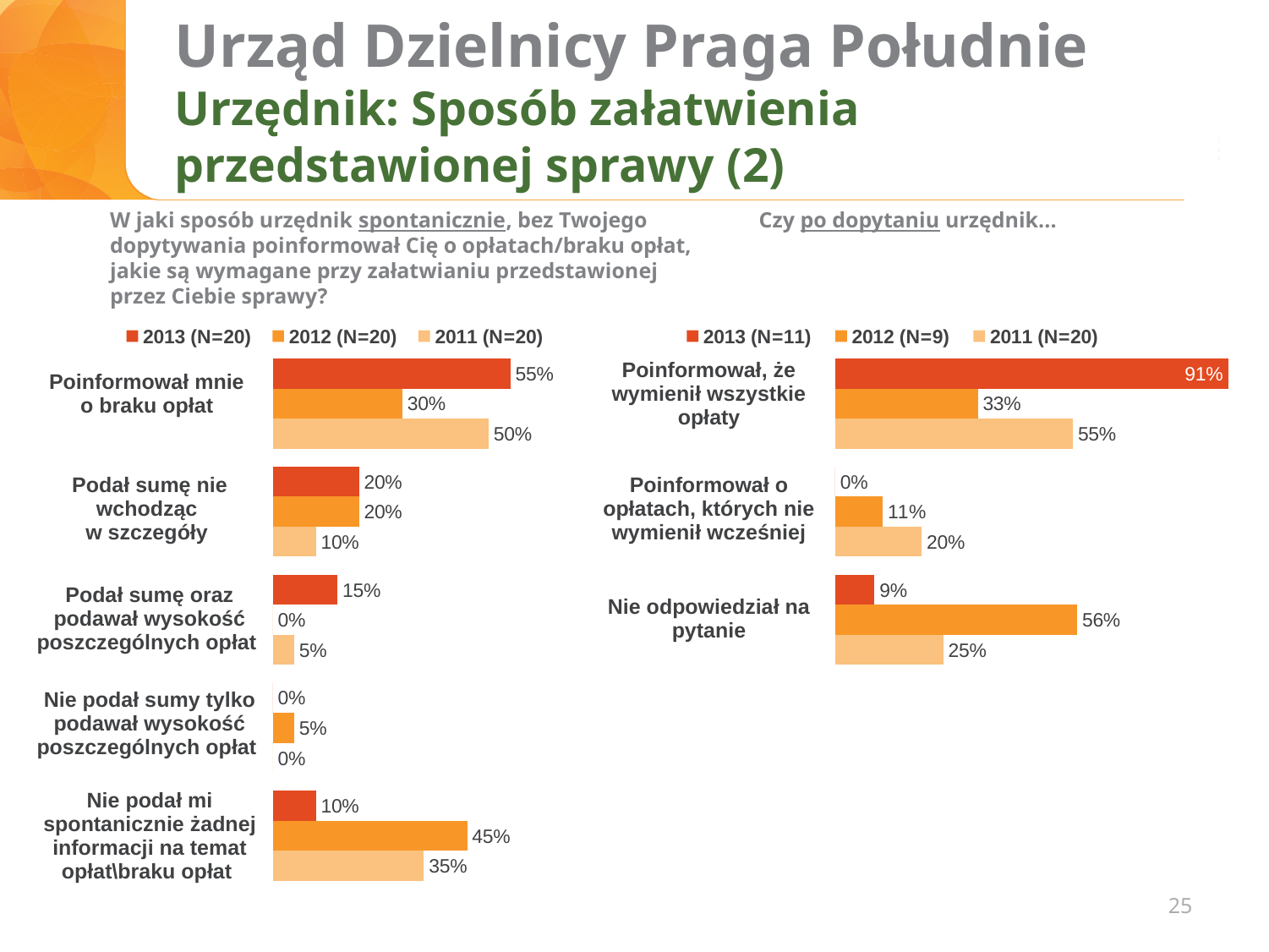
In the right chart, what is the difference between the 2013 and 2011 values for "Poinformował, że wymienił wszystkie opłaty"? 36 percentage points In the left chart, what is the 2012 value for "Nie podał mi spontanicznie żadnej informacji na temat opłat\braku opłat"? 45% In the right chart, which category has the lowest 2013 value? Poinformował o opłatach, których nie wymienił wcześniej In the right chart, what is the 2013 value for "Poinformował, że wymienił wszystkie opłaty"? 91% In the left chart, which category has the highest 2013 value? Poinformował mnie o braku opłat In the right chart, what is the 2012 value for "Nie odpowiedział na pytanie"? 56% In the left chart, which is larger for "Podał sumę nie wchodząc w szczegóły": the 2012 value or the 2011 value? 2012 How many series does the legend of the right chart list? 3 In the left chart, what is the difference between the 2013 and 2012 values for "Poinformował mnie o braku opłat"? 25 percentage points What type of chart is the right chart? Bar chart How many categories does the left chart show? 5 In the left chart, what is the 2013 value for "Poinformował mnie o braku opłat"? 55%